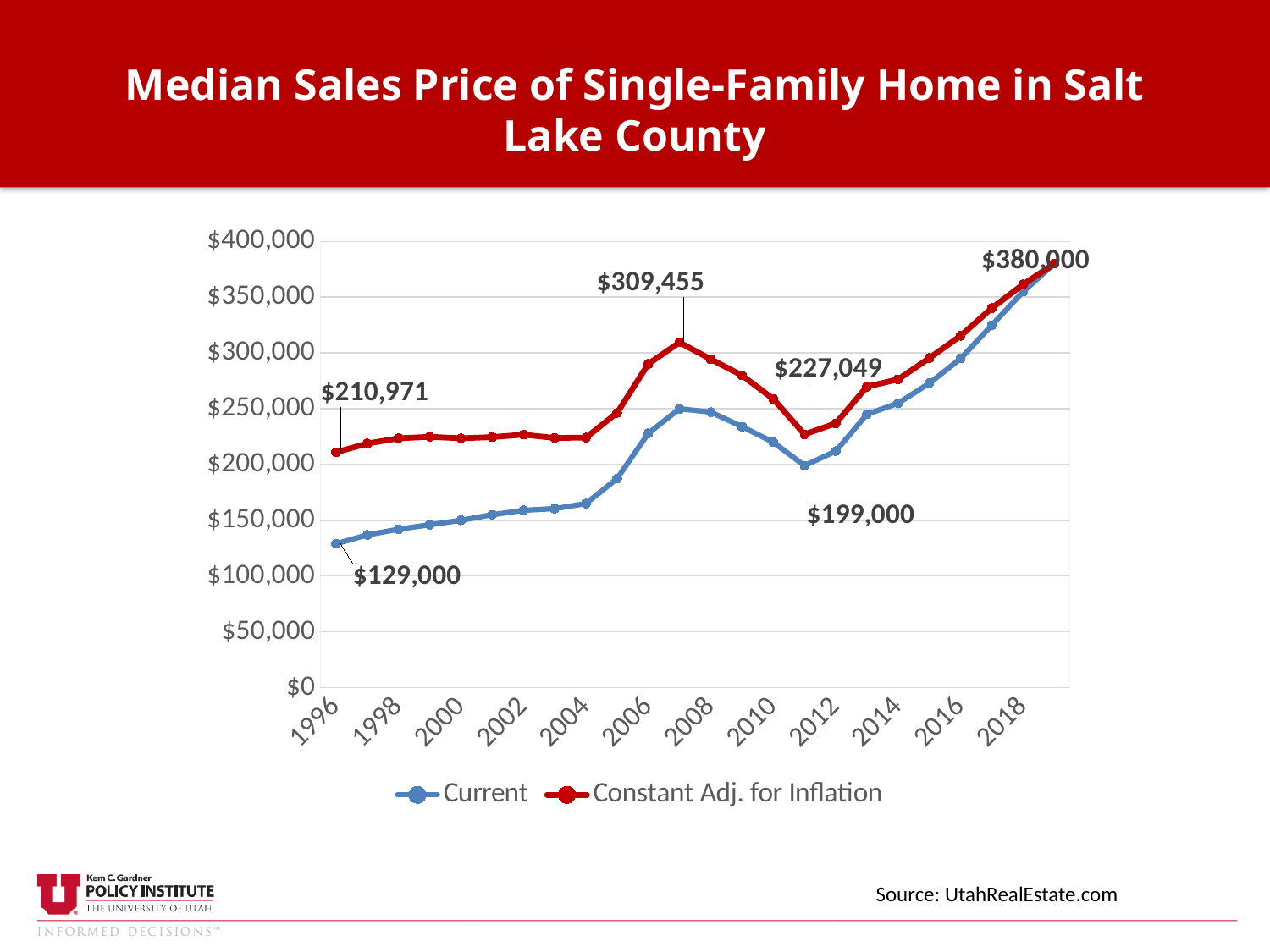
What is the Current median sales price in 1996? $129,000 What is the Constant Adj. for Inflation median sales price in 1996? $210,971 Does the Current line rise or fall from 2011 to 2018? rise What is the difference between the Constant Adj. for Inflation value and the Current value in 1996? $81,971 What is the Current median sales price labeled in 2011? $199,000 What is the peak value labeled on the Constant Adj. for Inflation line in 2007? $309,455 Is the Current value for 2004 greater or less than $200,000? less Which series has the higher value in 2007, Current or Constant Adj. for Inflation? Constant Adj. for Inflation What kind of chart is shown on the slide? line chart What is the difference between the Constant Adj. for Inflation value ($227,049) and the Current value ($199,000) in 2011? $28,049 How many series does the legend list? 2